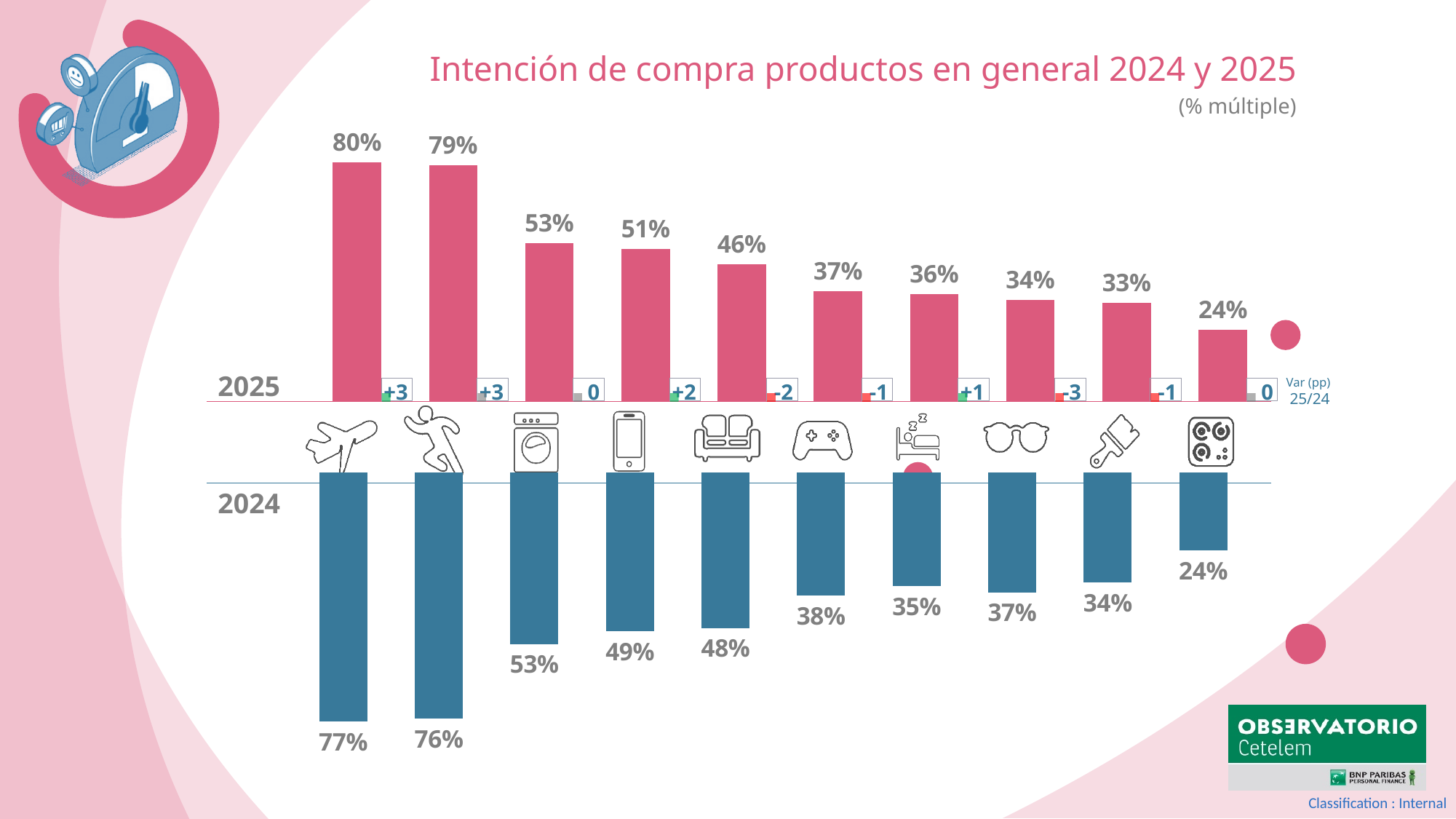
How many product categories are shown in the chart? 10 What is the title of the chart? Intención de compra productos en general 2024 y 2025 What is the 2024 value for the first category from the left (airplane icon)? 77% What is the 2025 value for the third category from the left (washing machine icon)? 53% What is the variation (Var pp 25/24) shown for the eighth category from the left (glasses icon)? -3 What is the highest 2025 value in the chart? 80% For the fifth category from the left (sofa icon), which year has the larger value, 2024 or 2025? 2024 What kind of chart is shown on the slide? bar chart What is the 2024 value for the last category on the right (cooktop icon)? 24% What is the lowest 2025 value in the chart? 24% By how many percentage points does the 2025 value exceed the 2024 value for the first category from the left (airplane icon)? 3 What is the 2024 value for the fourth category from the left (smartphone icon)? 49%